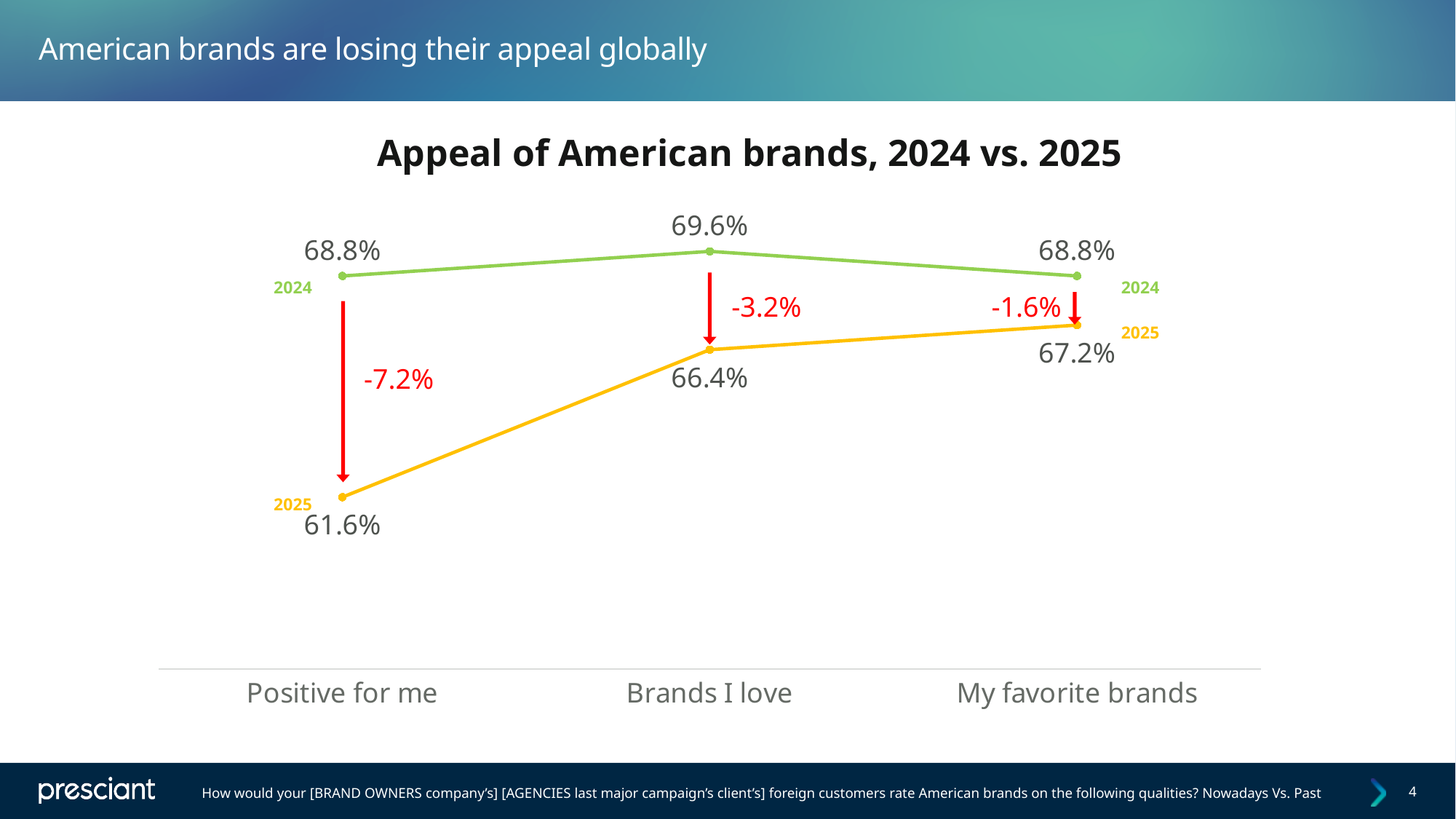
What is the 2024 value for "Positive for me"? 68.8% What is the difference between the 2024 and 2025 values for "Brands I love"? 3.2% What is the title of the chart? Appeal of American brands, 2024 vs. 2025 How many series (years) are plotted on the chart? 2 How many categories are shown on the x axis? 3 Which category has the lowest 2025 value? Positive for me What is the 2025 value for "Positive for me"? 61.6% Which category has the highest 2024 value? Brands I love What is the 2025 value for "My favorite brands"? 67.2% What kind of chart is shown? Line chart Which is larger, the 2025 value for "Brands I love" or the 2025 value for "My favorite brands"? My favorite brands What is the 2024 value for "Brands I love"? 69.6%